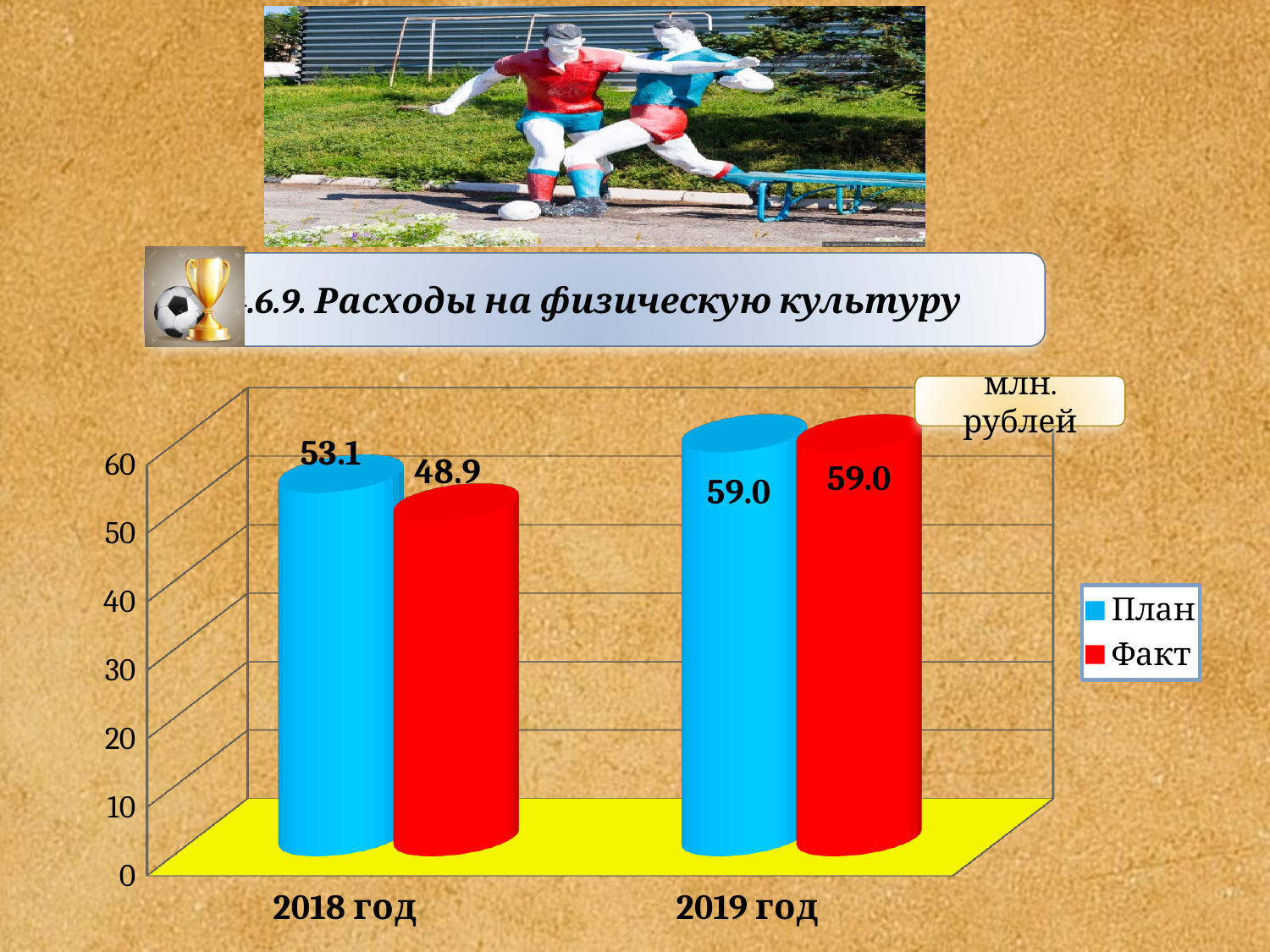
What is the Факт value for 2018 год? 48.9 Which is larger for 2018 год, План or Факт? План How many series does the legend list? 2 Which year has the lowest Факт value? 2018 год What kind of chart is this? bar chart What is the Факт value for 2019 год? 59.0 What is the План value for 2019 год? 59.0 How many year categories are shown on the x axis? 2 What unit is indicated for the values on the chart? млн. рублей What is the План value for 2018 год? 53.1 Does the Факт value rise or fall from 2018 год to 2019 год? rise What is the difference between the План and Факт values for 2018 год? 4.2